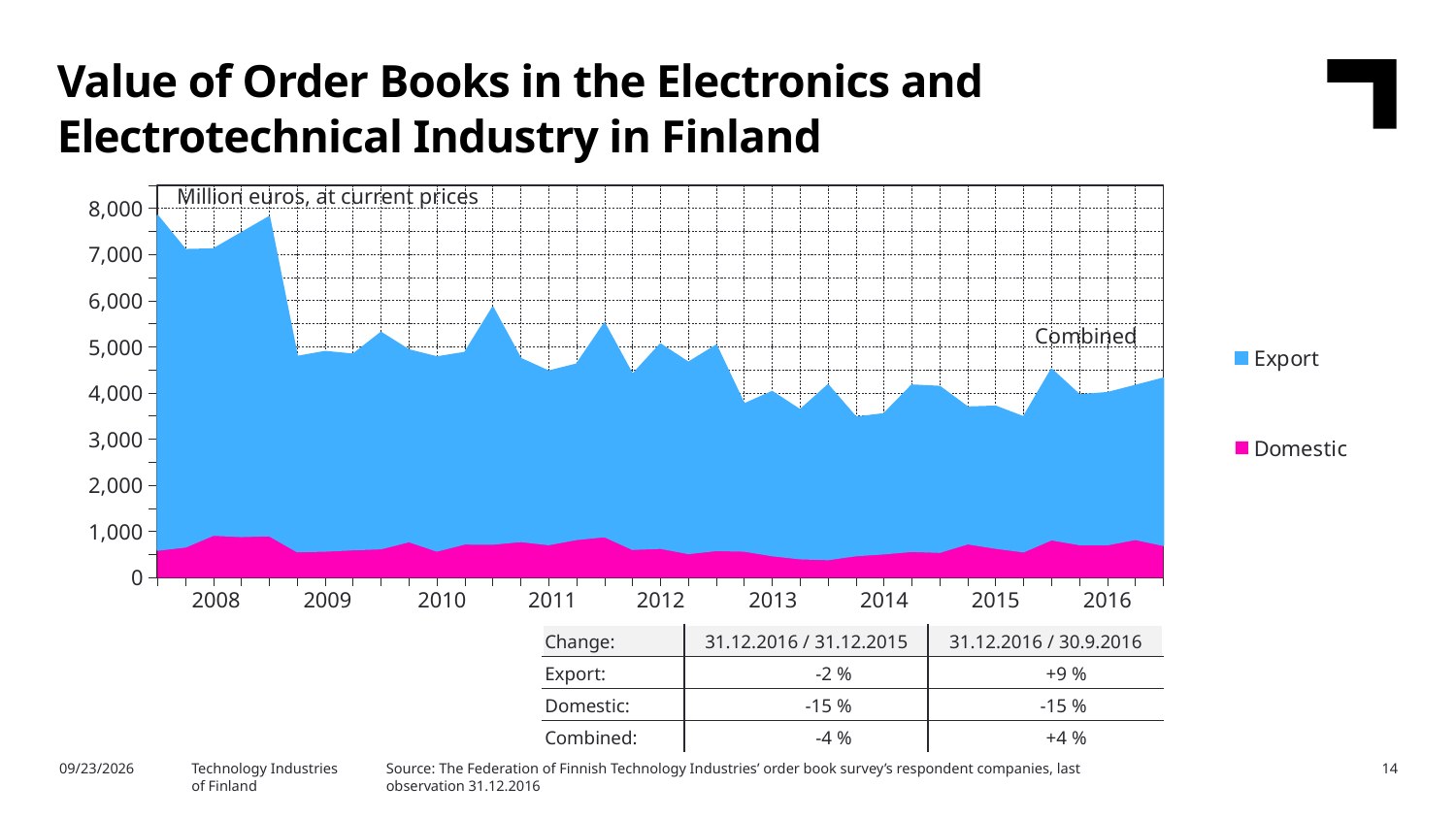
Is the combined value at the start of 2008 greater or less than 7,000? greater Is the Domestic value at any point greater or less than 1,000? less Which two series are listed in the chart legend? Export and Domestic In which year does the combined order book value reach its highest level? 2008 How many series does the chart legend list? 2 Which series accounts for the larger part of the combined order book value, Export or Domestic? Export How many years are labelled on the x axis of the chart? 9 What unit is stated for the values in the chart? Million euros, at current prices What type of chart is shown on the slide? Area chart Is the combined value during 2013 greater or less than 5,000? less Overall, do the combined order book values rise or fall from 2008 to 2016? Fall